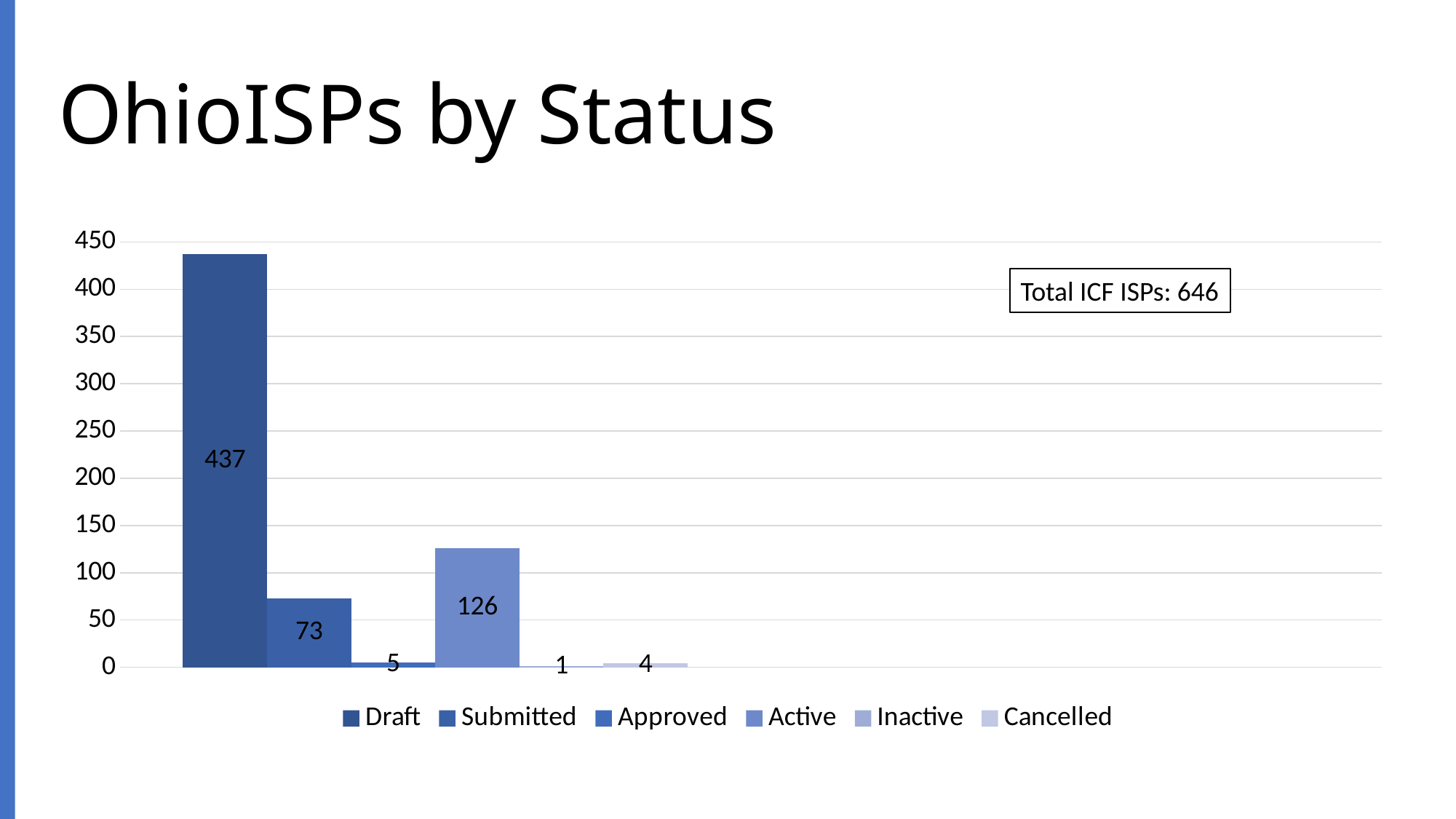
What is the value for Draft? 437 What total is shown in the text box on the chart? Total ICF ISPs: 646 How many series does the legend list? 6 Which is larger, Submitted or Active? Active Which status has the lowest value? Inactive What is the value for Approved? 5 What is the difference between the Draft and Active values? 311 What kind of chart is shown on the slide? Bar chart What is the value for Active? 126 What is the value for Submitted? 73 Which status has the highest value? Draft What is the value for Cancelled? 4